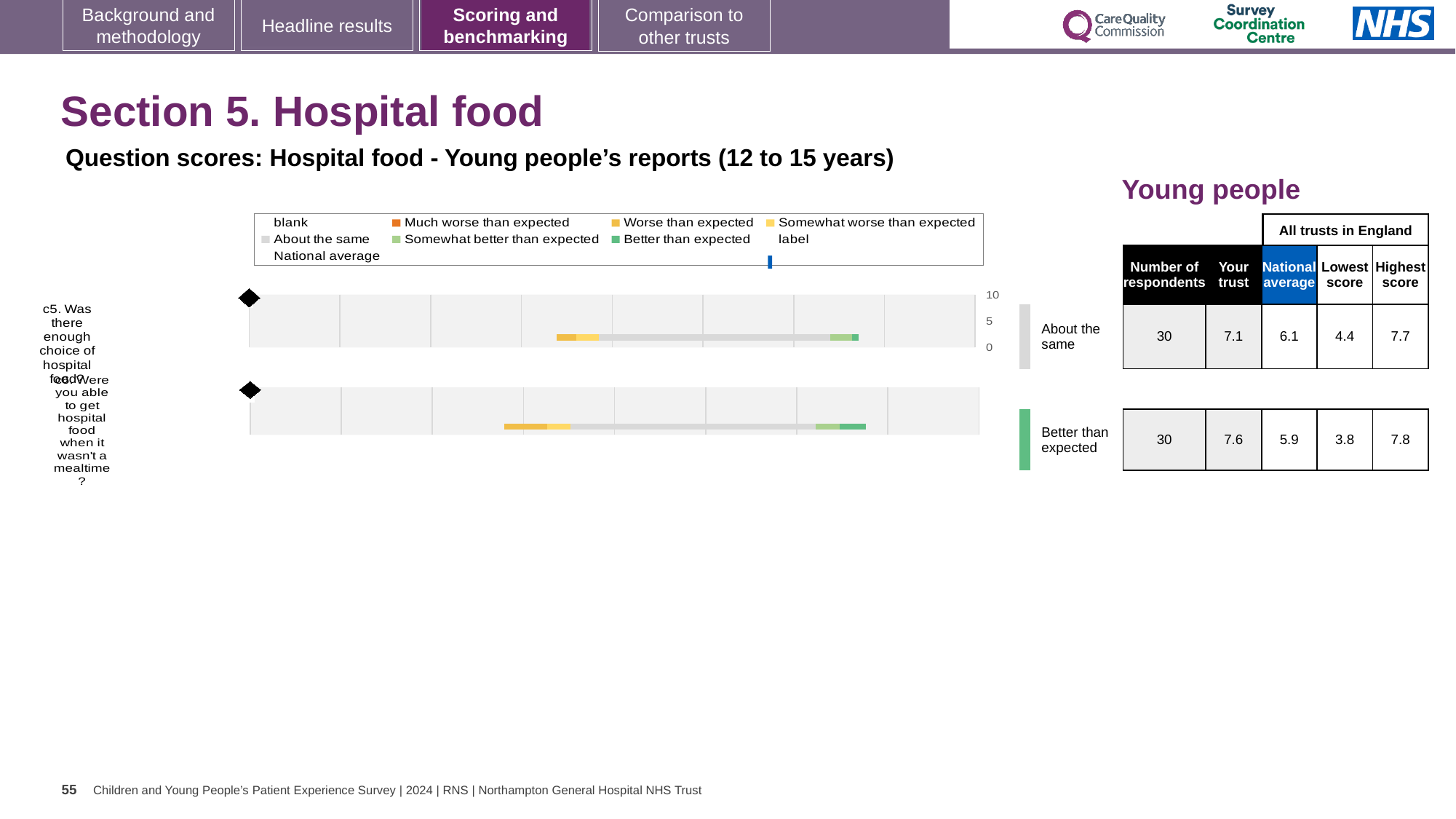
What is the 'Your trust' score for question c5 (enough choice of hospital food)? 7.1 What is the 'Your trust' score for question c6 (able to get hospital food when it wasn't a mealtime)? 7.6 How many respondents answered question c6? 30 Which benchmark category is shown for question c5 (enough choice of hospital food)? About the same How many questions (categories) are plotted in the hospital food chart? 2 What is the national average score for question c5? 6.1 What is the lowest score among all trusts in England for question c6? 3.8 Which question has the higher 'Your trust' score, c5 or c6? c6 What is the difference between the highest score and the lowest score for question c5? 3.3 What kind of chart is used to show the question scores for hospital food? bar chart What is the highest value shown on the chart's score axis? 10 By how much does the trust's score for question c6 exceed the national average? 1.7